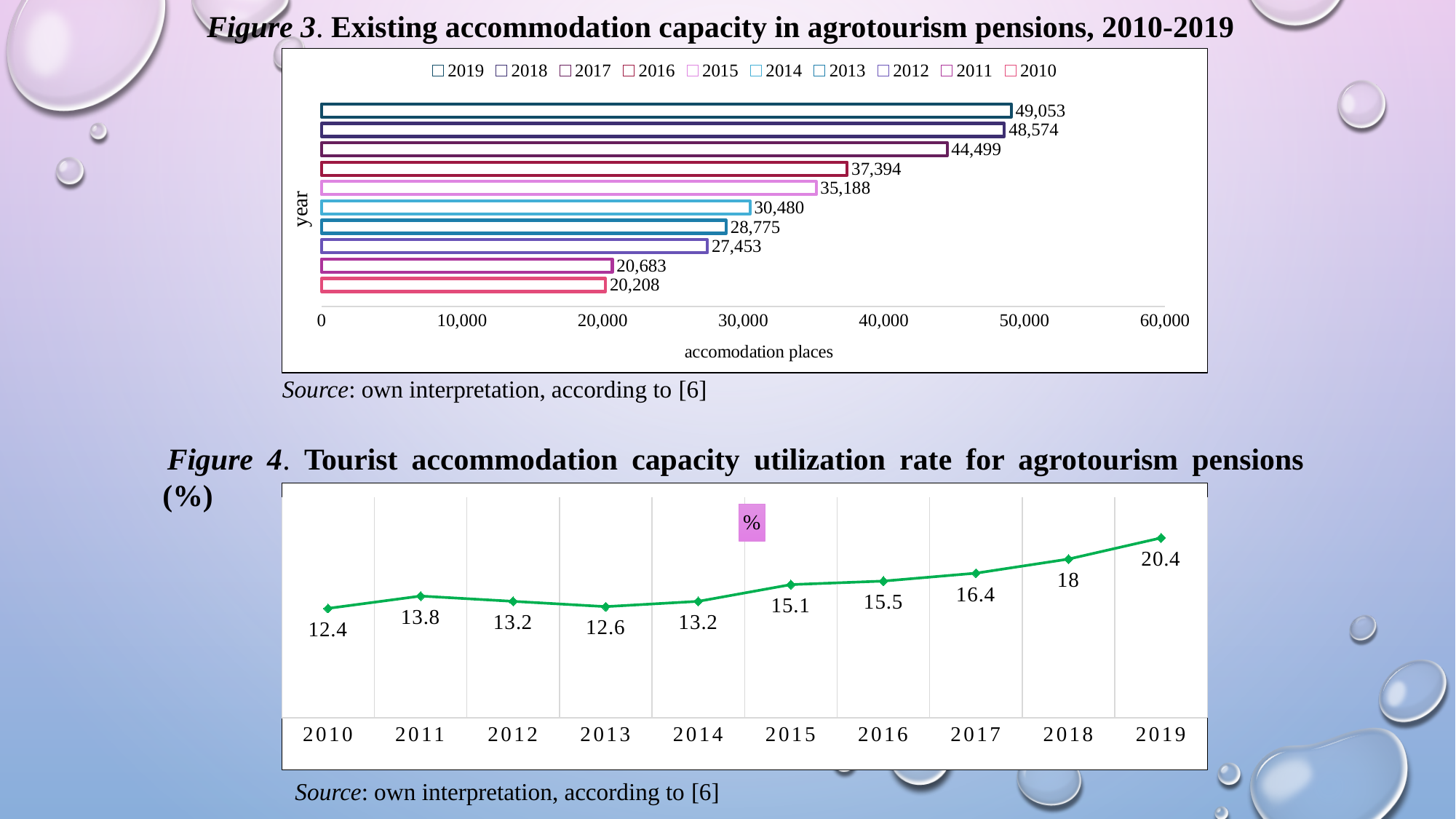
In Figure 3, which year has the highest accommodation capacity? 2019 In Figure 3, what is the existing accommodation capacity in agrotourism pensions for 2019? 49,053 In Figure 3, which year has more accommodation places, 2016 or 2015? 2016 In Figure 3, which year has the lowest accommodation capacity? 2010 In Figure 4, which year has the highest utilization rate? 2019 In Figure 3, what is the accommodation capacity for 2014? 30,480 In Figure 3, what is the difference in accommodation capacity between 2019 and 2010? 28,845 In Figure 4, what is the tourist accommodation capacity utilization rate for 2013? 12.6 In Figure 4, what is the overall trend of the utilization rate from 2014 to 2019? Rising In Figure 4, what is the difference in utilization rate between 2019 and 2010? 8 In Figure 3, how many years are listed in the legend? 10 What type of chart is Figure 3? Bar chart